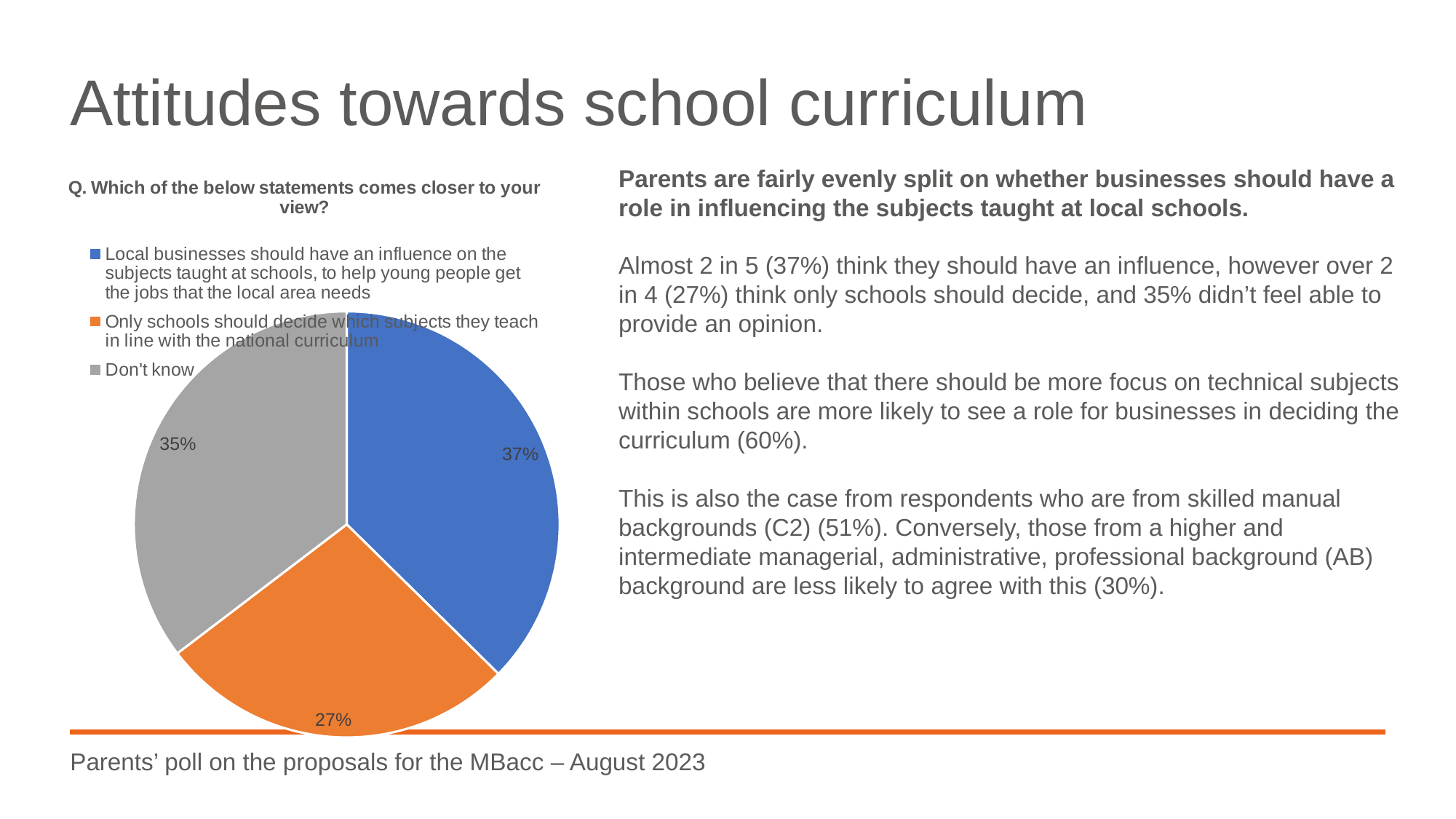
What percentage of parents answered 'Don't know'? 35% What percentage of parents said local businesses should have an influence on the subjects taught at schools? 37% Which response has the largest share of the pie? Local businesses should have an influence on the subjects taught at schools, to help young people get the jobs that the local area needs Which response has the smallest share of the pie? Only schools should decide which subjects they teach in line with the national curriculum What is the difference in percentage points between the 'Local businesses should have an influence' slice and the 'Only schools should decide' slice? 10 What colour is the 'Don't know' slice? grey What question is shown as the chart's title? Q. Which of the below statements comes closer to your view? What kind of chart is shown on the slide? pie chart Which is larger: the 'Don't know' slice or the 'Only schools should decide' slice? Don't know How many entries does the legend list? 3 How many slices does the pie chart have? 3 What percentage of parents said only schools should decide which subjects they teach? 27%